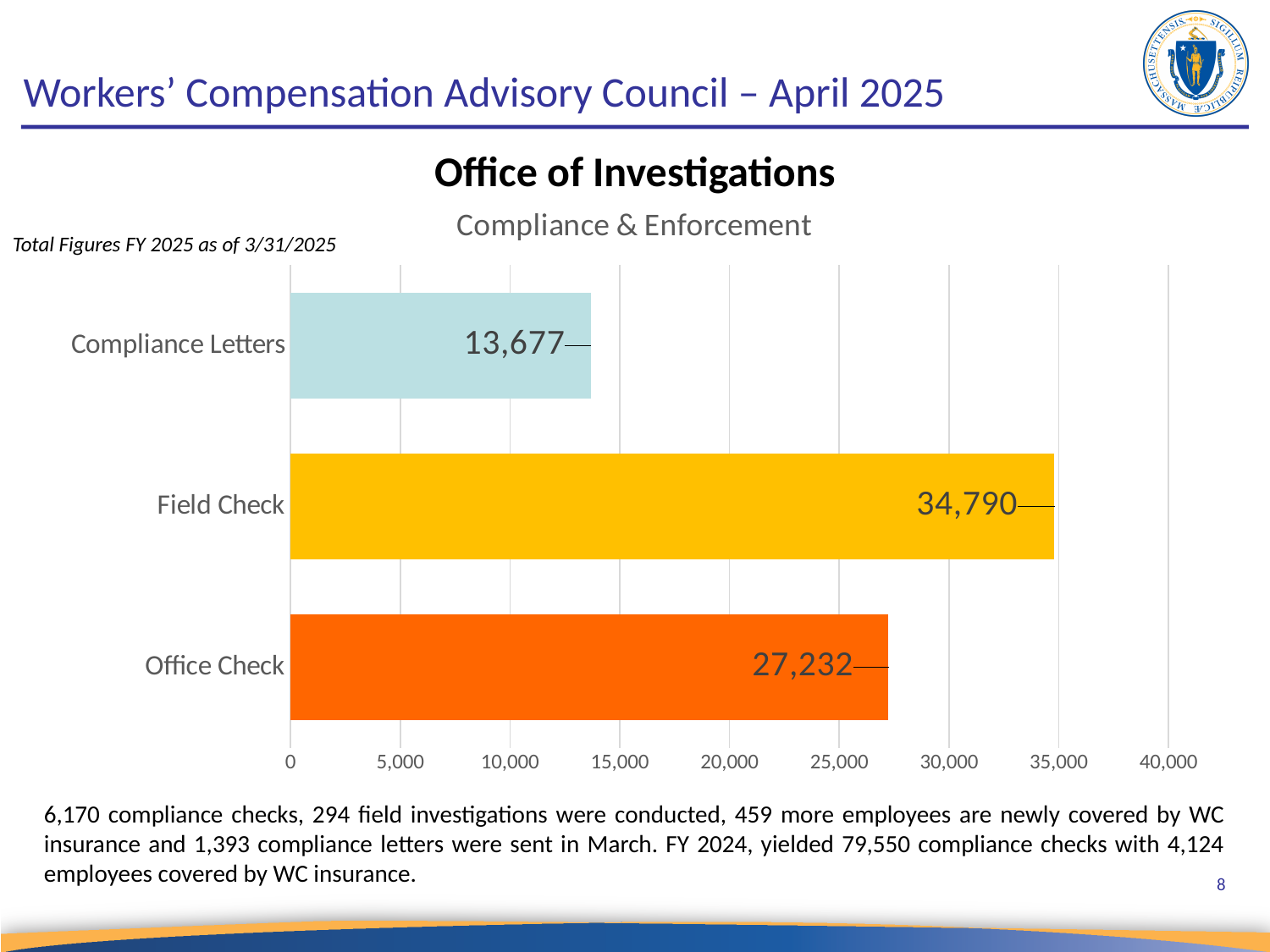
What is the difference between the Office Check and Compliance Letters values? 13,555 What is the value for Compliance Letters? 13,677 Is the value for Field Check greater or less than 30,000? greater What is the difference between the Field Check and Office Check values? 7,558 What is the value for Office Check? 27,232 Which category has the lowest value? Compliance Letters What is the title of the chart? Compliance & Enforcement What is the value for Field Check? 34,790 What kind of chart is shown on the slide? Bar chart Which is larger, Office Check or Compliance Letters? Office Check How many categories are shown in the chart? 3 Which category has the highest value? Field Check